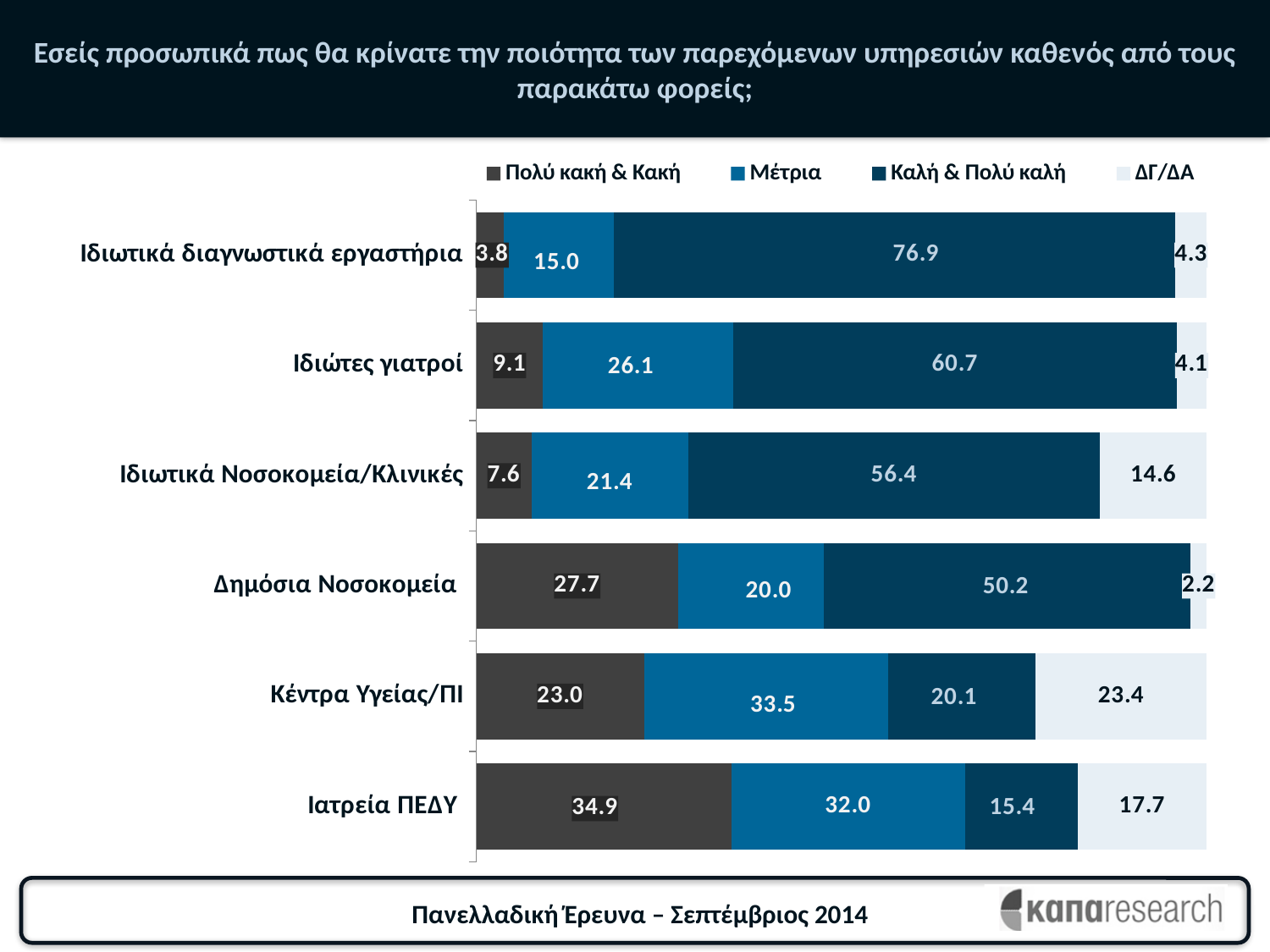
How many categories (providers) are shown on the chart? 6 What is the value of 'Καλή & Πολύ καλή' for 'Ιδιωτικά διαγνωστικά εργαστήρια'? 76.9 Which legend entry is shown in the lightest colour? ΔΓ/ΔΑ How many series does the legend list? 4 What is the value of 'Μέτρια' for 'Κέντρα Υγείας/ΠΙ'? 33.5 What kind of chart is shown on the slide? Stacked bar chart What is the total of the stacked bar for 'Κέντρα Υγείας/ΠΙ'? 100.0 What is the value of 'ΔΓ/ΔΑ' for 'Ιδιωτικά Νοσοκομεία/Κλινικές'? 14.6 Which is larger: the 'Μέτρια' value for 'Ιδιώτες γιατροί' or for 'Δημόσια Νοσοκομεία'? Ιδιώτες γιατροί What is the difference between the 'Καλή & Πολύ καλή' values for 'Ιδιωτικά διαγνωστικά εργαστήρια' and 'Ιδιώτες γιατροί'? 16.2 Which category has the highest value for 'Πολύ κακή & Κακή'? Ιατρεία ΠΕΔΥ Which category has the lowest value for 'Καλή & Πολύ καλή'? Ιατρεία ΠΕΔΥ